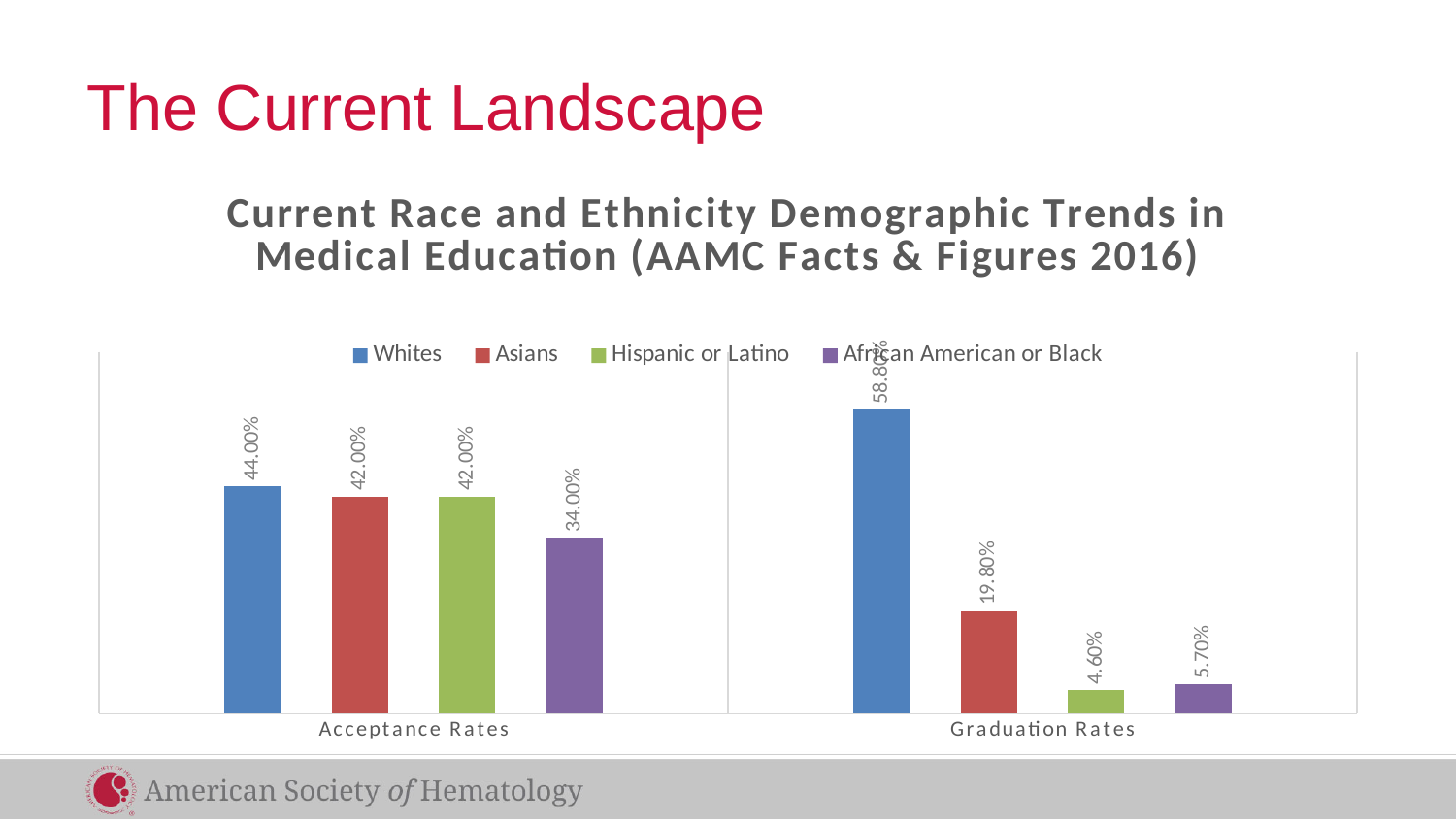
What is the acceptance rate for Whites? 44.00% What is the graduation rate for Hispanic or Latino? 4.60% How many series does the legend list? 4 What kind of chart is shown on the slide? Bar chart Which group has the highest graduation rate? Whites What is the graduation rate for African American or Black? 5.70% What colour represents Hispanic or Latino in the chart? Green What is the difference between the acceptance rate for Whites and the acceptance rate for African American or Black? 10.00% What is the difference between the graduation rate for Whites and the graduation rate for Asians? 39.00% How many categories are shown on the x axis? 2 Which group has the lowest acceptance rate? African American or Black Which is larger: the graduation rate for Asians or the graduation rate for African American or Black? Asians